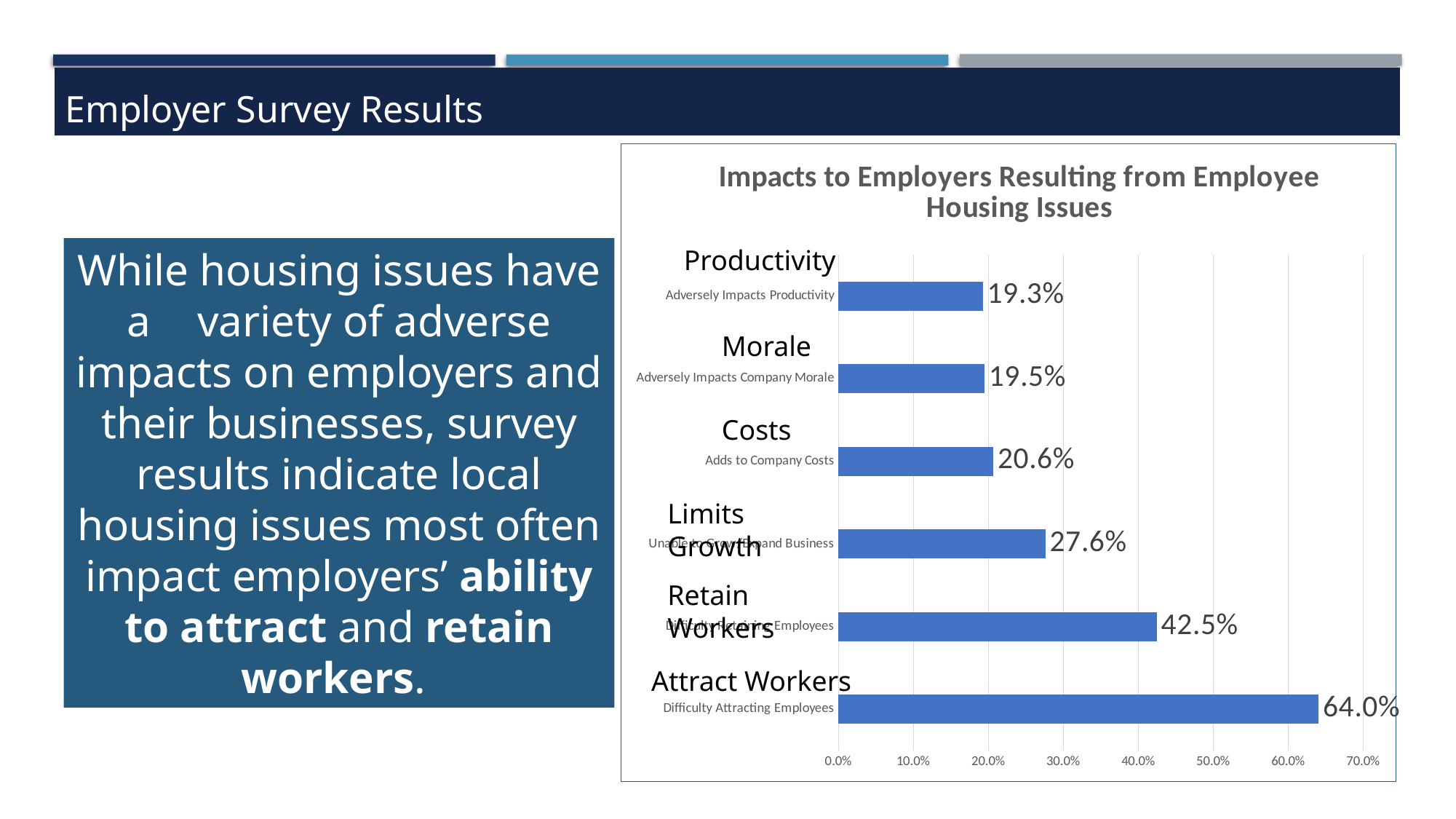
Which impact has the lowest percentage in the chart? Adversely Impacts Productivity What value is shown for 'Adds to Company Costs'? 20.6% What is the difference between the percentages for 'Difficulty Attracting Employees' and 'Difficulty Retaining Employees'? 21.5% Which is larger: the value for 'Adds to Company Costs' or for 'Adversely Impacts Company Morale'? Adds to Company Costs How many impact categories are shown in the chart? 6 What percentage is shown for 'Unable to Grow/Expand Business'? 27.6% What percentage is shown for 'Adversely Impacts Company Morale'? 19.5% Which impact has the highest percentage in the chart? Difficulty Attracting Employees What type of chart is used to show the impacts to employers? Bar chart What value is shown for 'Difficulty Retaining Employees'? 42.5% What percentage of employers reported difficulty attracting employees? 64.0% Is the value for 'Unable to Grow/Expand Business' greater or less than 30.0%? less